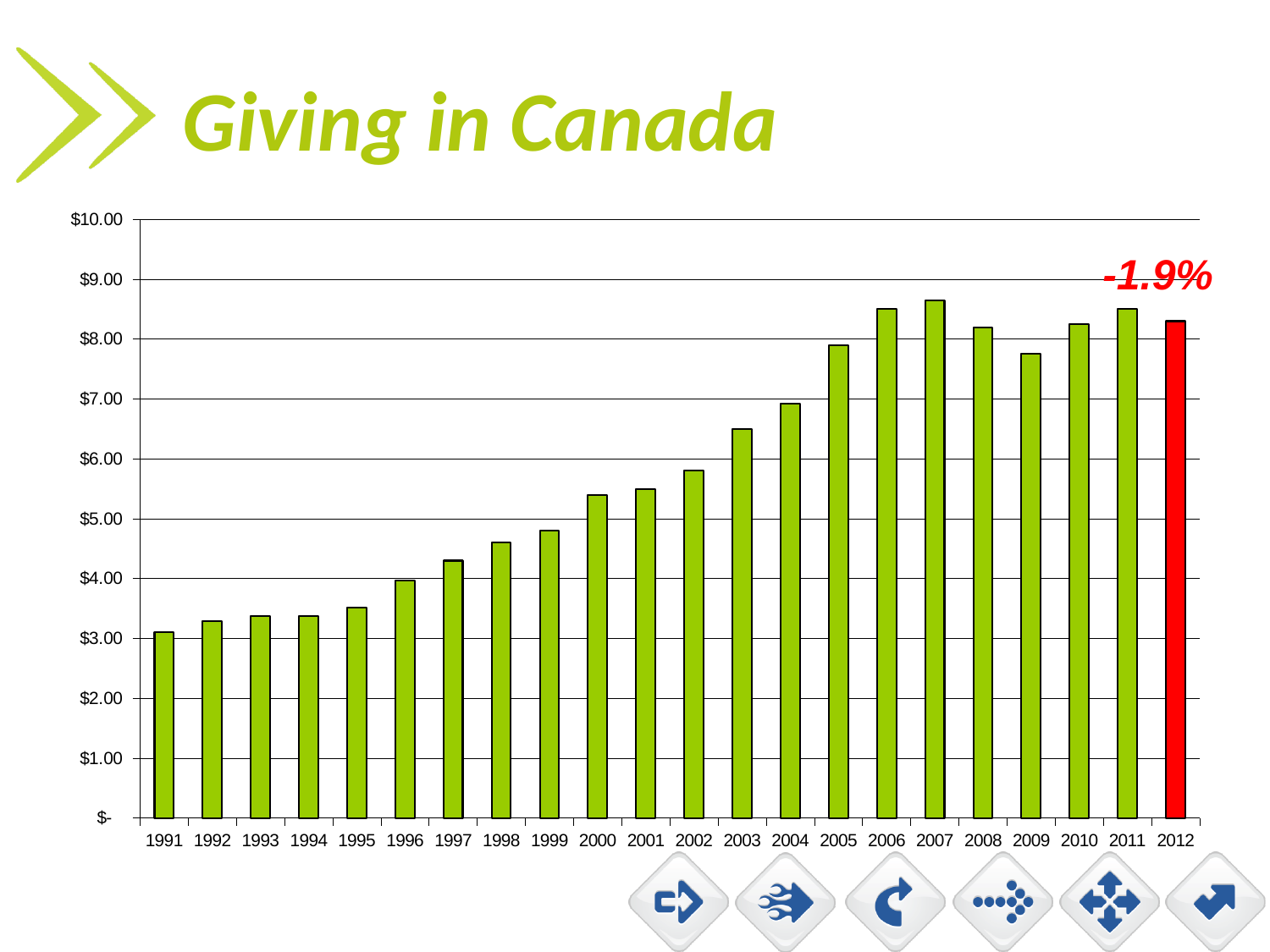
Which year's bar is coloured red instead of green? 2012 Is the value for 2009 greater or less than $8.00? less Is the value for 2003 greater or less than $6.00? greater Do the values generally rise or fall from 1991 to 2007? rise What percentage change is annotated in red above the 2012 bar? -1.9% Which year has the larger value, 2004 or 2005? 2005 Which year has the lowest bar in the chart? 1991 Which year has the highest bar in the chart? 2007 What kind of chart is shown on the slide? bar chart Is the value for 2007 greater or less than $8.00? greater How many years are plotted on the x axis of the chart? 22